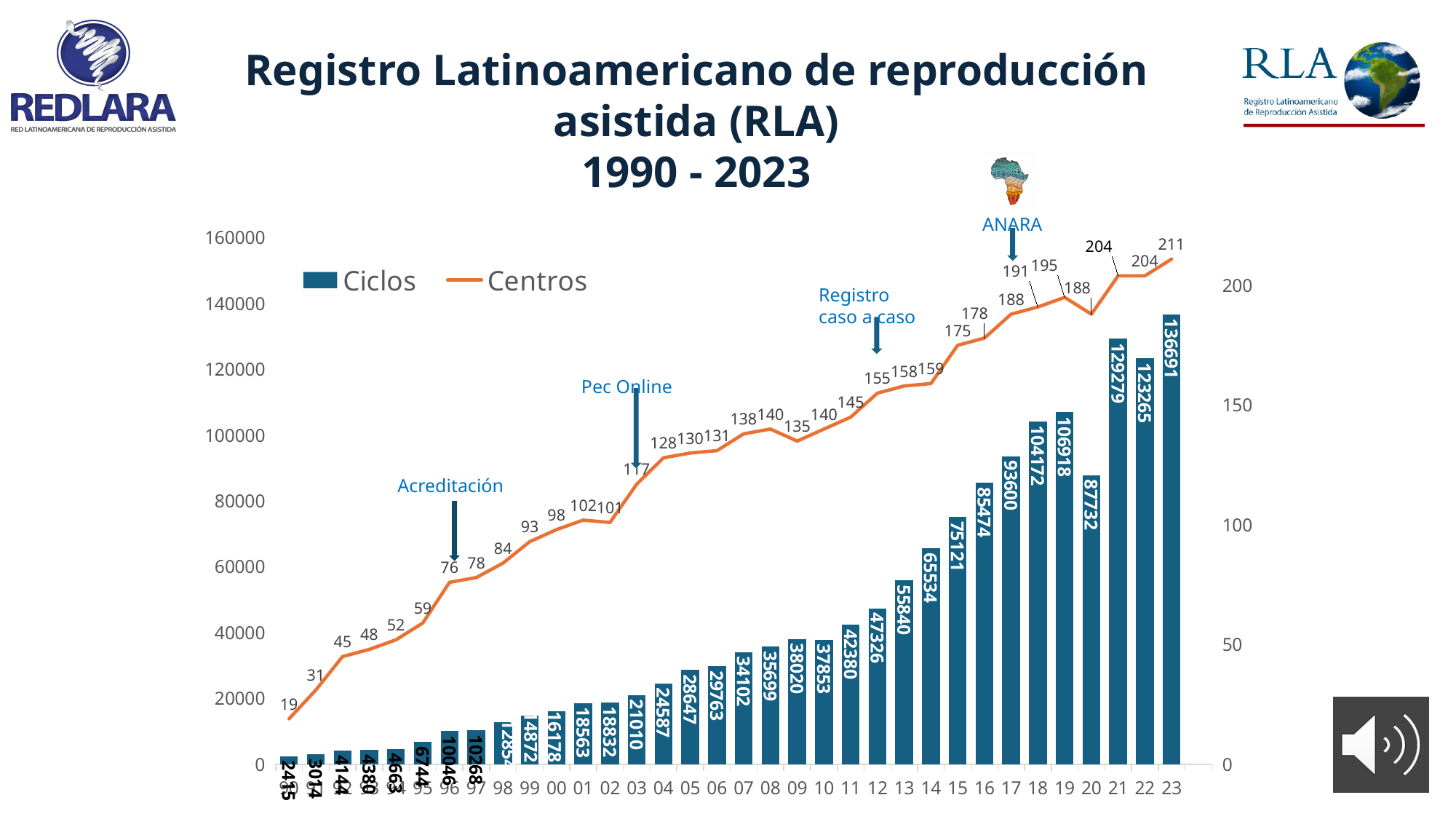
What are the two series named in the legend? Ciclos and Centros What is the value of Centros for 1990? 19 What is the value of Ciclos for 2023? 136691 What is the difference in Ciclos between 2021 and 2022? 6014 Which year has the highest value of Ciclos? 2023 How many series does the legend list? 2 What is the value of Centros for 2023? 211 Overall, do the Ciclos values rise or fall from 1990 to 2023? rise Which year has more Ciclos, 2019 or 2020? 2019 What is the value of Ciclos for 2020? 87732 Which year has the lowest value of Ciclos? 1990 What is the value of Centros in the year labelled with the 'Pec Online' annotation (2003)? 117